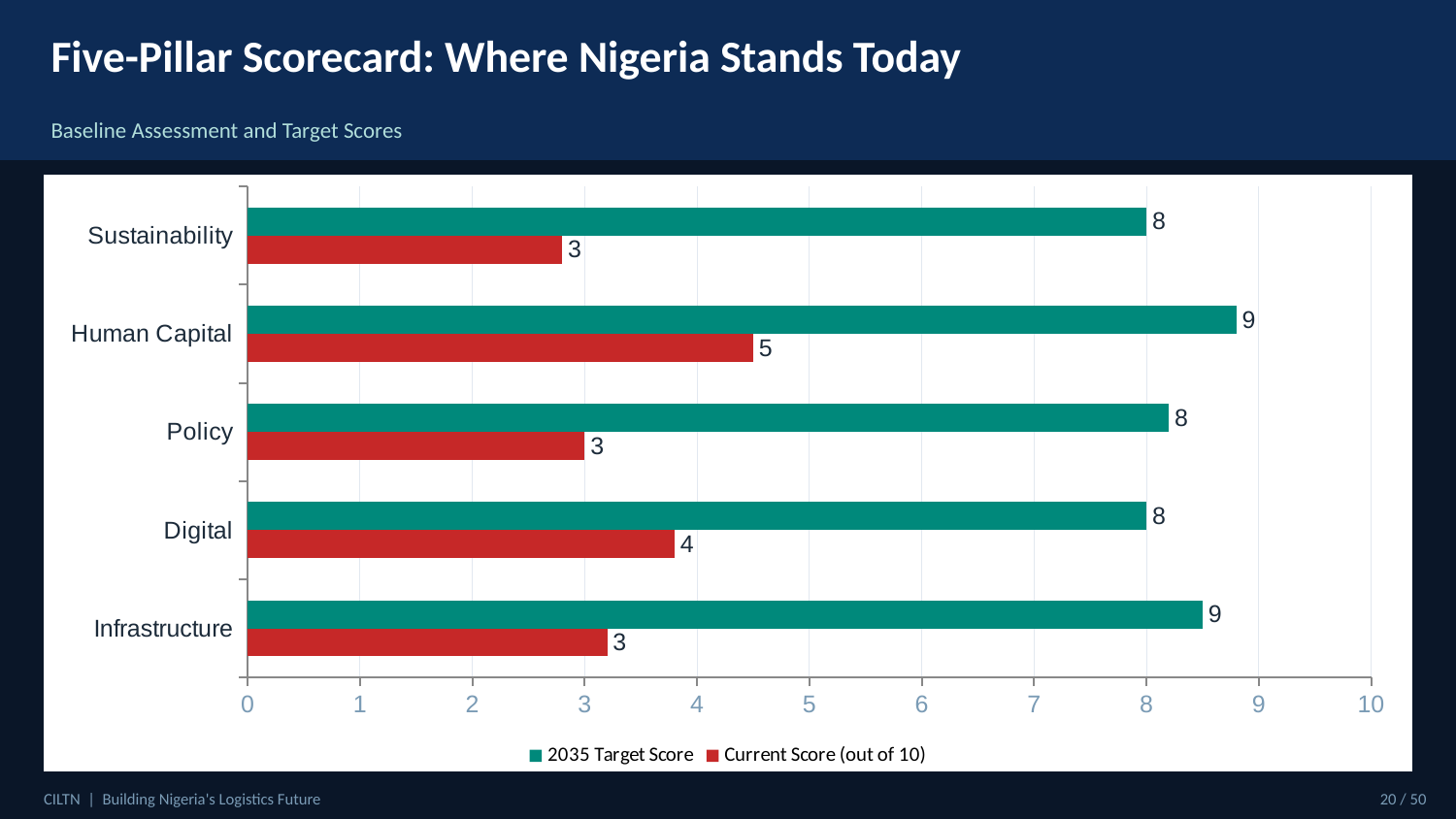
Is the 2035 Target Score for Policy greater or less than 5? greater How many pillars are shown on the chart? 5 Which colour represents the 2035 Target Score series? teal (green) What is the Current Score (out of 10) for Digital? 4 What kind of chart is shown on the slide? bar chart What is the Current Score (out of 10) for Human Capital? 5 What is the 2035 Target Score for Sustainability? 8 Which pillar has the highest Current Score (out of 10)? Human Capital What is the 2035 Target Score for Infrastructure? 9 What is the Current Score (out of 10) for Policy? 3 How many series does the legend list? 2 Is the Current Score for Human Capital larger or smaller than the Current Score for Digital? larger